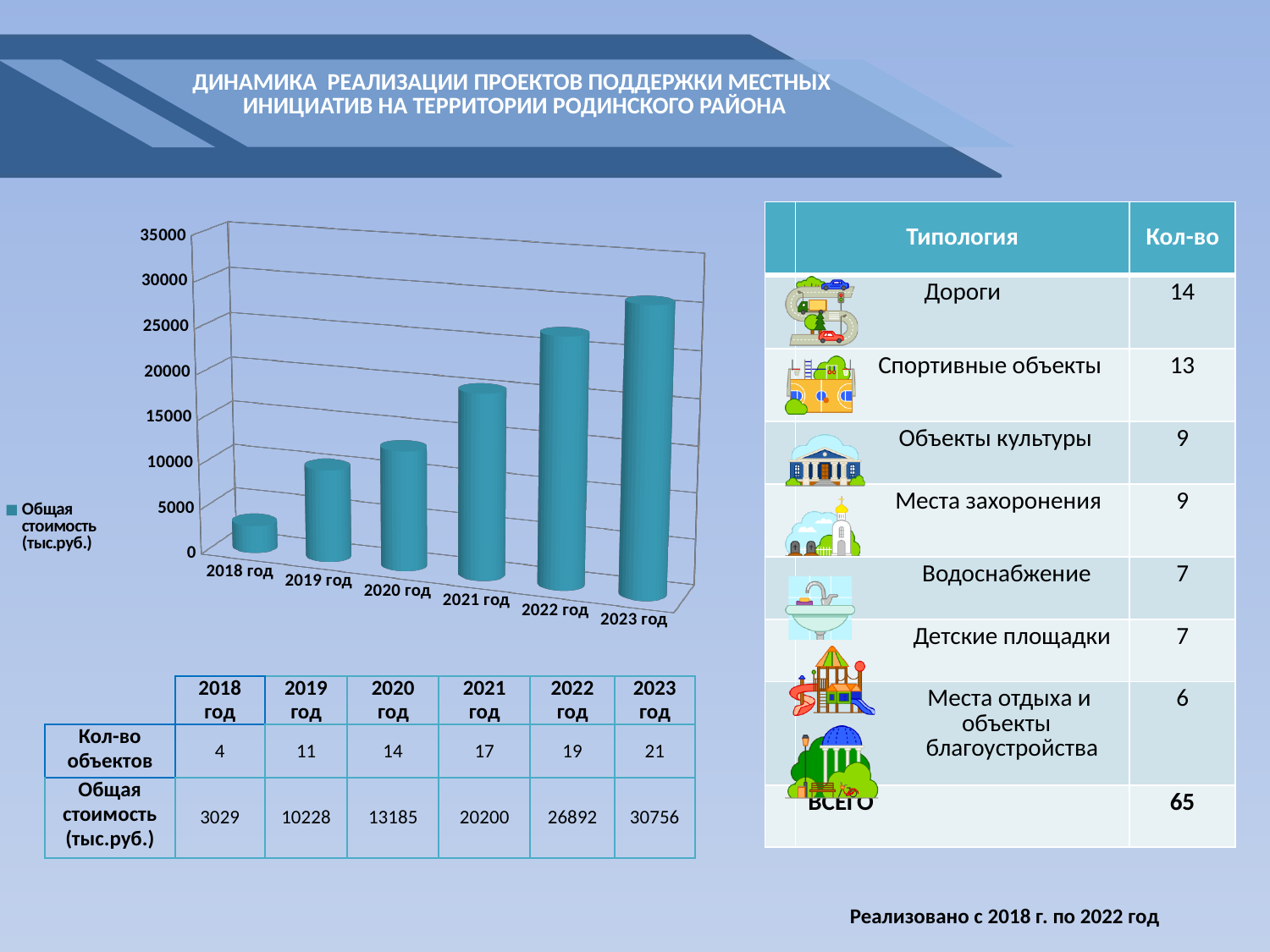
Is the value for 2022 год greater or less than 25000? greater Is the value for 2018 год greater or less than 5000? less What is the name of the series shown in the chart legend? Общая стоимость (тыс.руб.) What kind of chart is shown on the slide? bar chart Which year has the lowest bar on the chart? 2018 год How many years (categories) are plotted on the chart? 6 How many series does the chart legend list? 1 Do the bar values rise or fall from 2018 to 2023? rise Which is larger, the value for 2019 год or the value for 2020 год? 2020 год Is the value for 2021 год greater or less than 15000? greater Which year has the highest bar on the chart? 2023 год According to the table under the chart, what is the total cost (Общая стоимость) for 2023 год? 30756